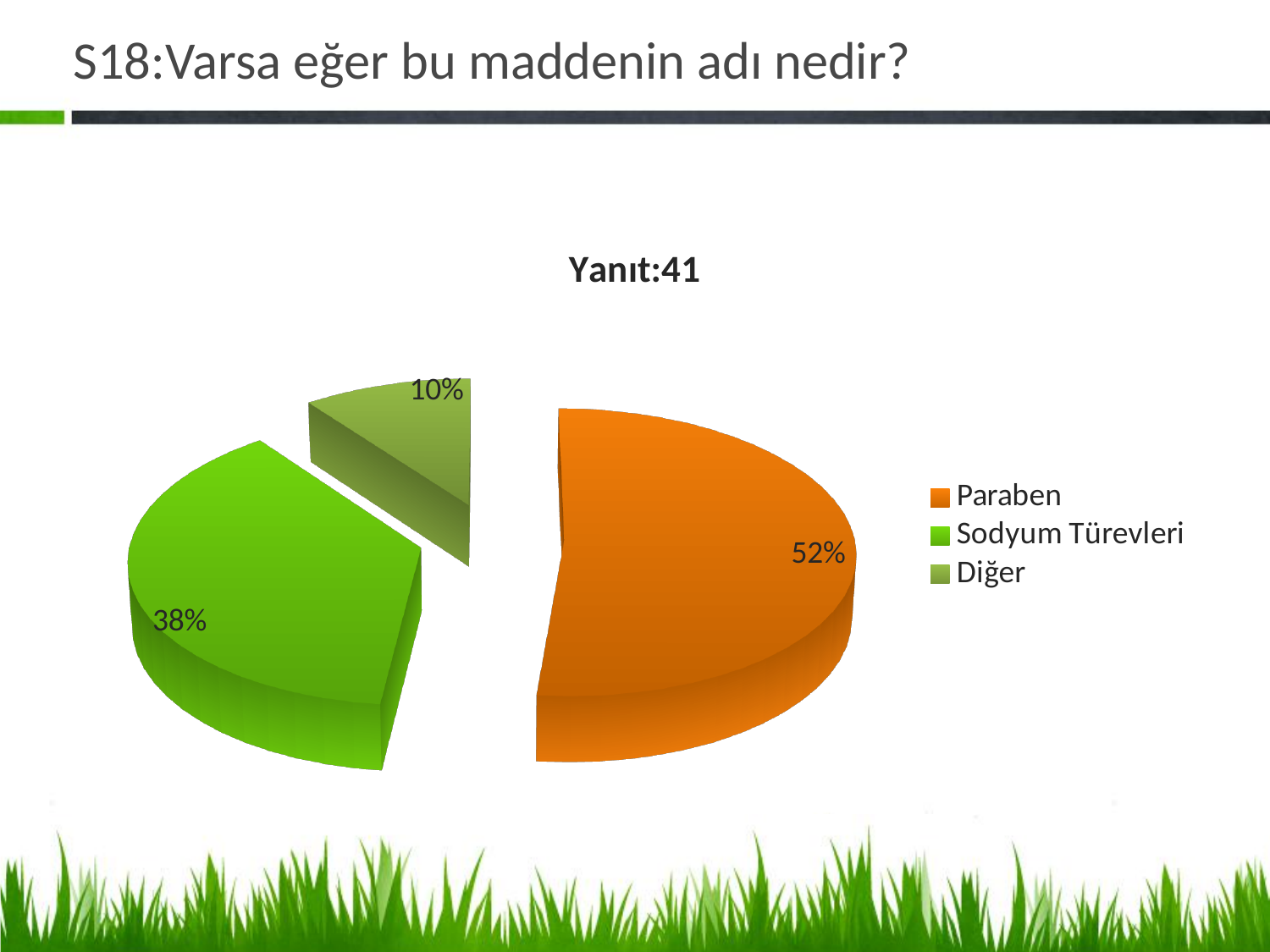
Which is larger, the share for Sodyum Türevleri or the share for Diğer? Sodyum Türevleri How many categories does the pie chart have? 3 What percentage share does Sodyum Türevleri have? 38% What percentage share does Diğer have? 10% Which colour represents Paraben in the legend? orange What is the difference in percentage points between Sodyum Türevleri and Diğer? 28 What is the difference in percentage points between Paraben and Sodyum Türevleri? 14 What is the chart's title? Yanıt:41 What percentage share does Paraben have? 52% Which category has the largest slice of the pie? Paraben Which category has the smallest slice of the pie? Diğer What kind of chart is shown on the slide? pie chart